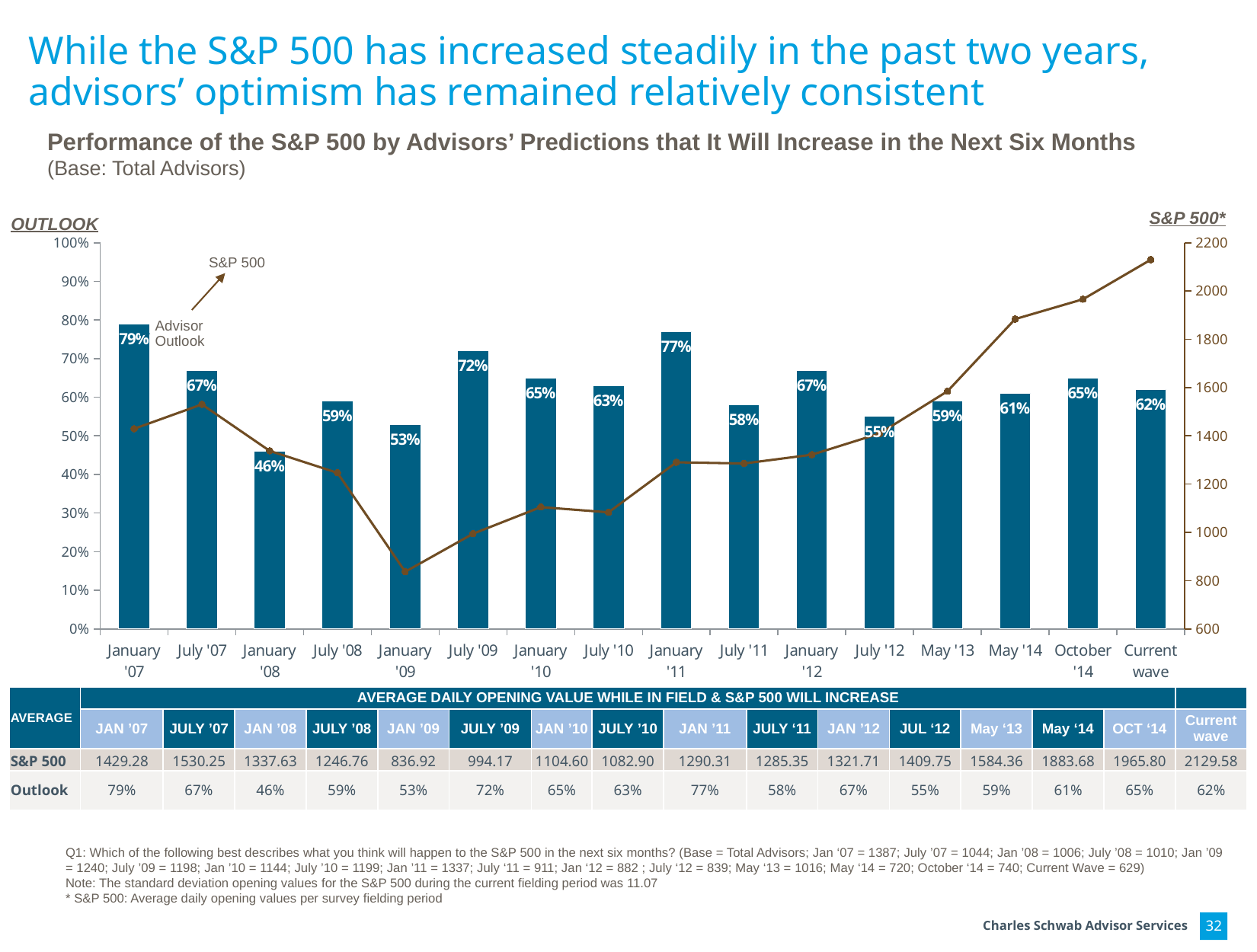
In which period is the S&P 500 average daily opening value lowest? January '09 Which period has the highest Advisor Outlook percentage? January '07 Which period has the lowest Advisor Outlook percentage? January '08 How many survey periods are plotted on the chart? 16 What is the Advisor Outlook value for January '07? 79% Which is larger, the Advisor Outlook for January '11 or for July '11? January '11 Is the S&P 500 value for May '14 greater or less than 1800? greater What is the difference in Advisor Outlook between January '07 and January '08? 33 percentage points Does the S&P 500 line rise or fall from January '09 to the Current wave? Rises What kind of chart is shown on the slide? Combined bar and line chart What is the S&P 500 average daily opening value for the Current wave? 2129.58 What is the Advisor Outlook value for July '09? 72%